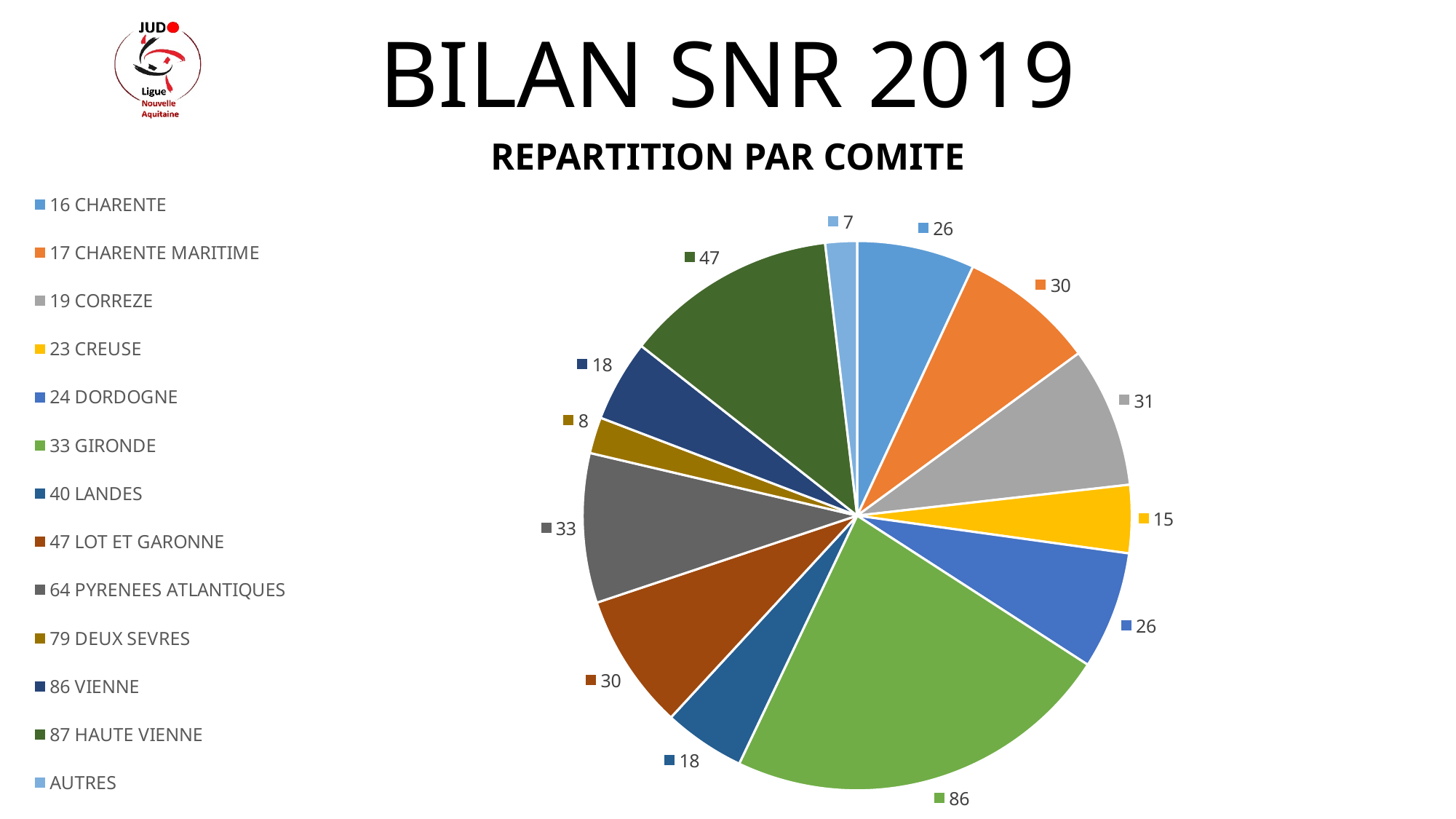
What is the value for 33 GIRONDE? 86 What is the title of the chart? REPARTITION PAR COMITE What is the value for 23 CREUSE? 15 What is the difference between the values for 87 HAUTE VIENNE and 16 CHARENTE? 21 How many categories does the pie chart have? 13 What is the value for 87 HAUTE VIENNE? 47 What kind of chart is shown on the slide? pie chart Which category has the largest slice of the pie? 33 GIRONDE Which category has the smallest slice of the pie? AUTRES What is the value for 64 PYRENEES ATLANTIQUES? 33 What is the difference between the values for 33 GIRONDE and 79 DEUX SEVRES? 78 Which is larger, the value for 19 CORREZE or the value for 17 CHARENTE MARITIME? 19 CORREZE